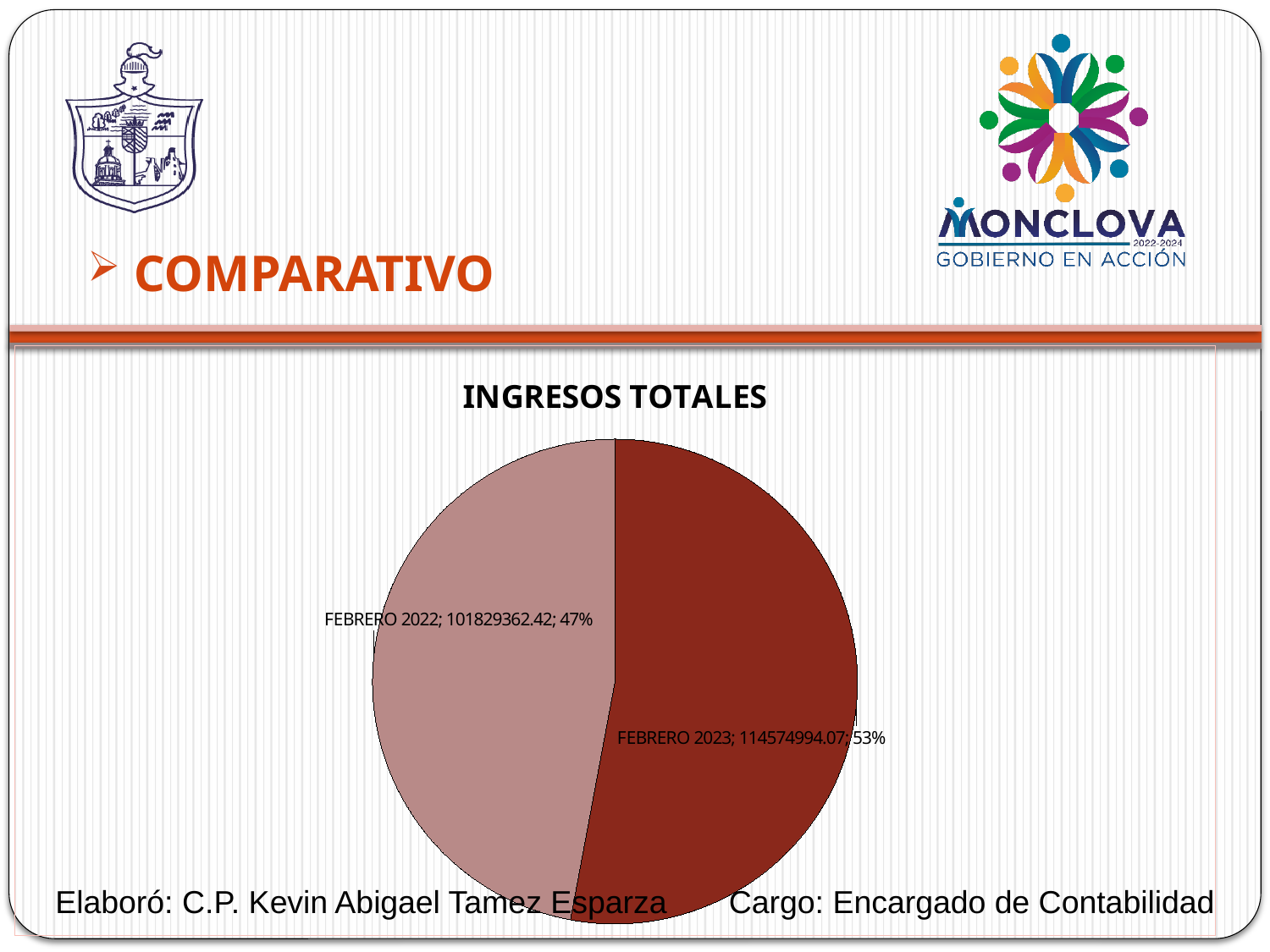
Which slice is the smallest? FEBRERO 2022 What kind of chart is shown on the slide? pie chart What share of the pie does FEBRERO 2023 represent? 53% What is the total of the two values shown in the pie chart? 216404356.49 What is the title of the chart? INGRESOS TOTALES How many slices does the pie chart have? 2 Which is larger, FEBRERO 2022 or FEBRERO 2023? FEBRERO 2023 What is the value for FEBRERO 2022? 101829362.42 Which slice is the largest? FEBRERO 2023 What is the value for FEBRERO 2023? 114574994.07 What is the difference between the values for FEBRERO 2023 and FEBRERO 2022? 12745631.65 What share of the pie does FEBRERO 2022 represent? 47%